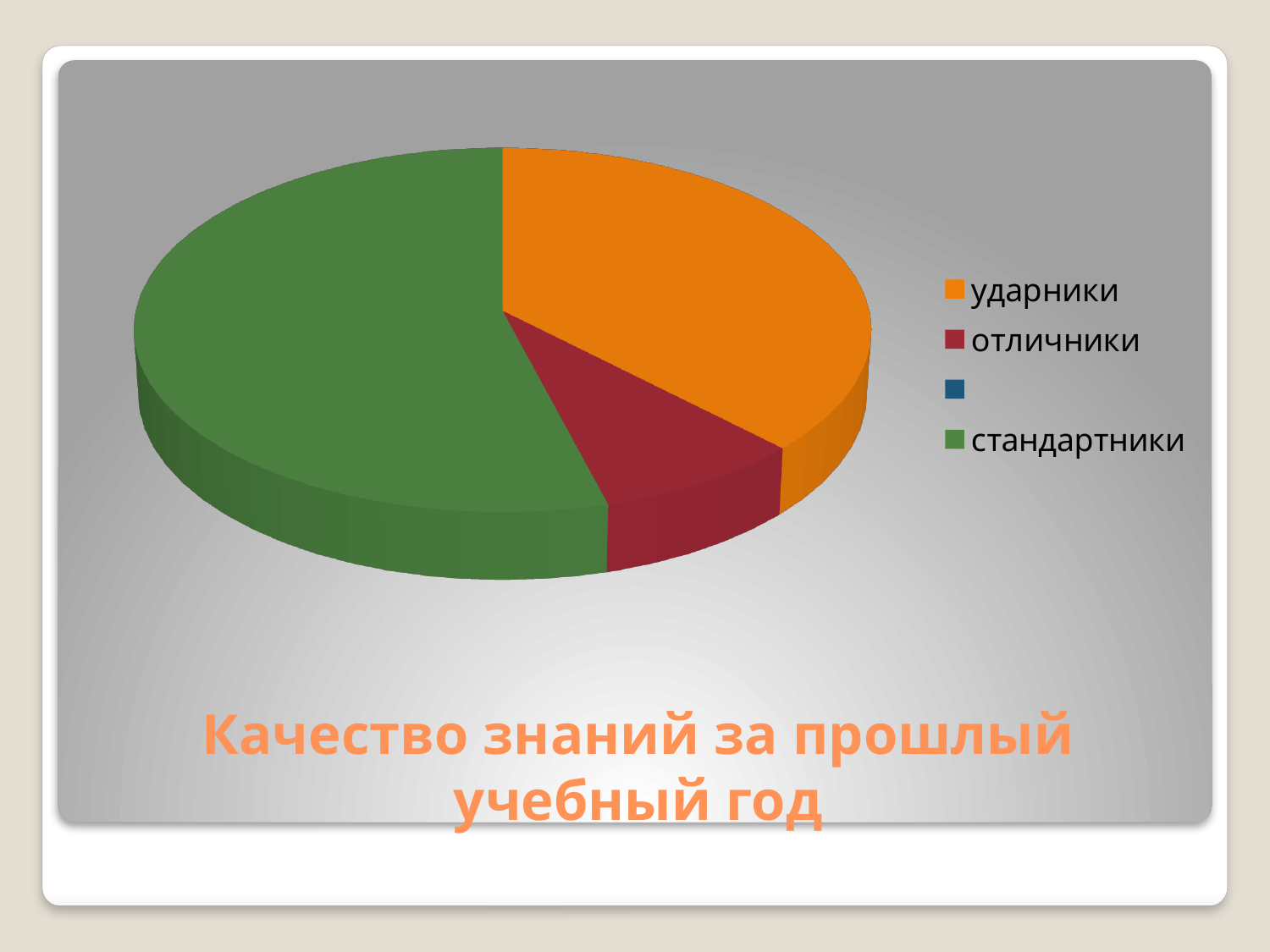
Which category has the smallest slice of the pie? отличники Which slice is larger, стандартники or ударники? стандартники Which category has the largest slice of the pie? стандартники What colour is the slice for стандартники? green What kind of chart is shown on the slide? pie chart Which slice is larger, ударники or отличники? ударники How many labelled categories does the legend list? 3 What is the title of the chart? Качество знаний за прошлый учебный год How many slices are visible in the pie chart? 3